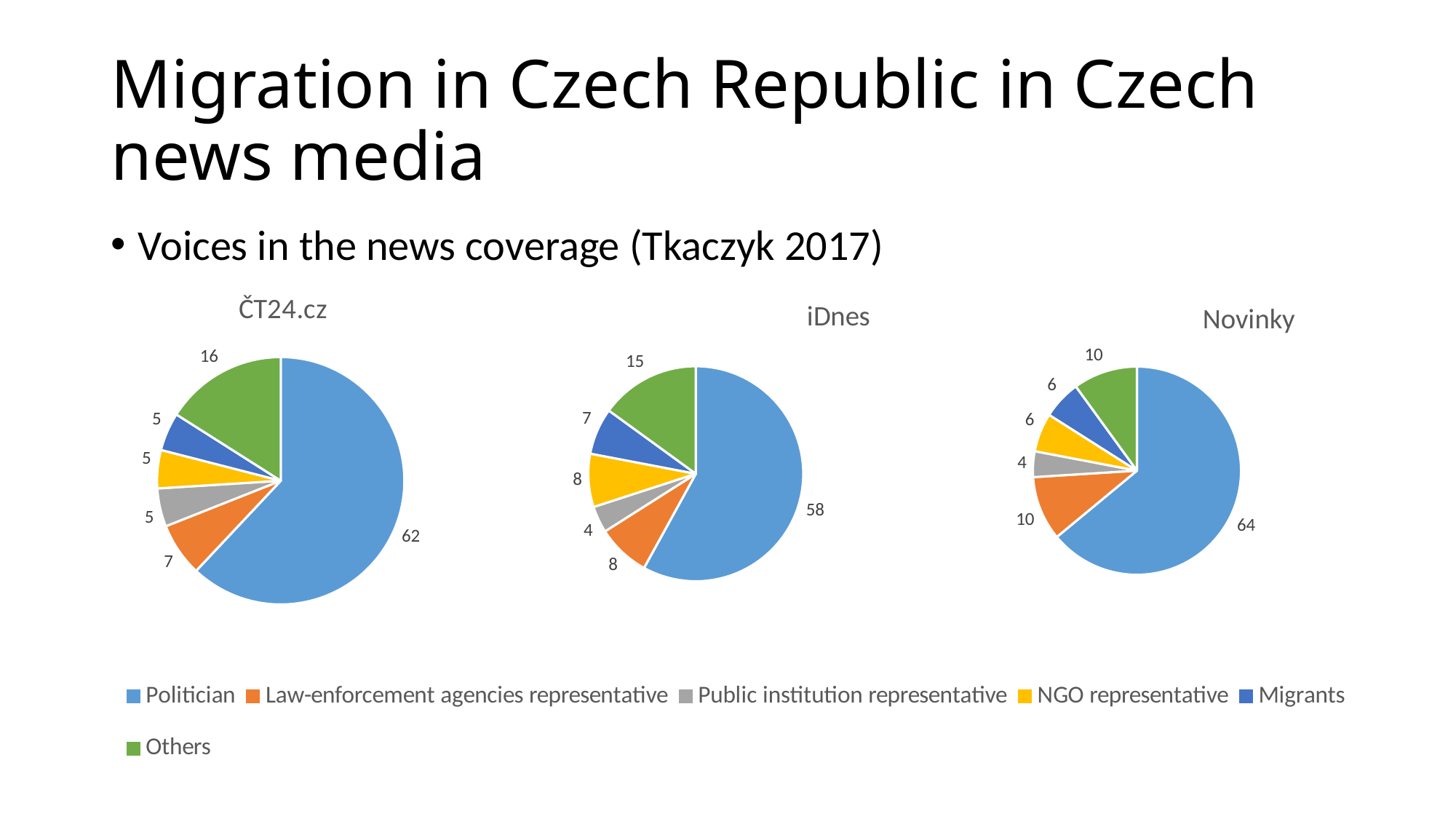
In the iDnes pie chart, what is the value for Migrants? 7 How many categories does the legend list? 6 How many slices does the ČT24.cz pie chart have? 6 In the ČT24.cz pie chart, what is the difference between the Politician value and the Others value? 46 In the ČT24.cz pie chart, what is the value for Politician? 62 Which colour represents NGO representative in the charts? Yellow In the iDnes pie chart, what is the value for Others? 15 In the iDnes pie chart, which category has the smallest slice? Public institution representative Which is larger: the Politician value in the Novinky chart or the Politician value in the iDnes chart? Novinky In the Novinky pie chart, what is the value for Law-enforcement agencies representative? 10 In the Novinky pie chart, which category has the largest slice? Politician What kind of chart is used for iDnes? Pie chart